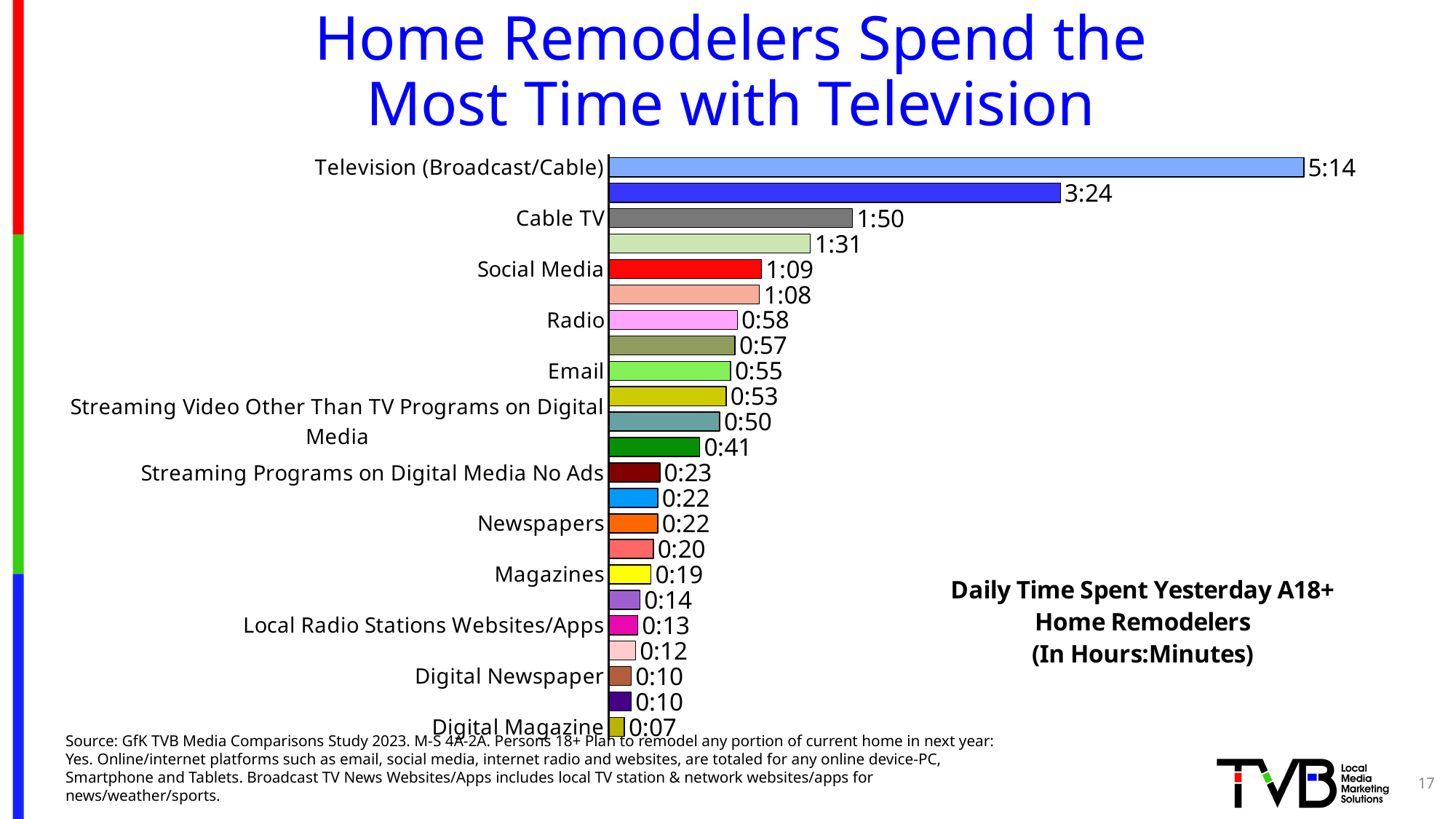
Which has a larger daily time spent, Magazines or Local Radio Stations Websites/Apps? Magazines What is the daily time spent with Email? 0:55 What type of chart is shown on the slide? bar chart What is the daily time spent with Newspapers? 0:22 What is the daily time spent with Cable TV? 1:50 What is the daily time spent with Television (Broadcast/Cable)? 5:14 Which category has the lowest daily time spent? Digital Magazine What is the daily time spent with Digital Magazine? 0:07 Which category has the highest daily time spent? Television (Broadcast/Cable) What is the difference in daily time spent between Television (Broadcast/Cable) and Cable TV? 3:24 What is the daily time spent with Social Media? 1:09 What is the daily time spent with Radio? 0:58